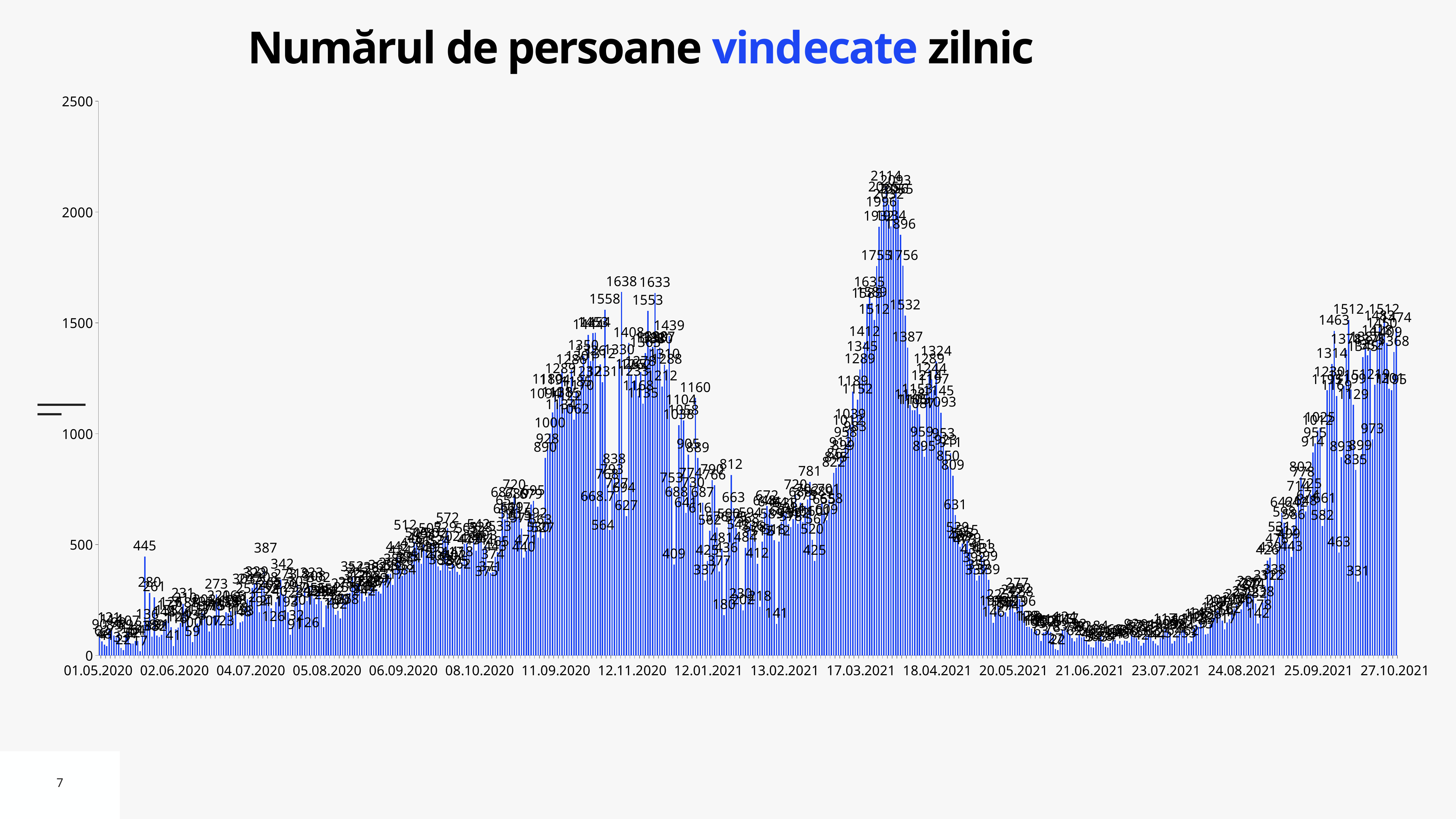
Do the values rise or fall between 20.05.2021 and 21.06.2021? fall Is the highest bar near 17.03.2021 greater or less than 2000? greater Do the values rise or fall between 24.08.2021 and 27.10.2021? rise What is the highest daily value labelled on the chart? 2114 What kind of chart is shown on the slide? bar chart What is the difference between the overall peak value (2114) and the November 2020 peak value (1638)? 476 What is the highest value labelled in the peak around 12.11.2020? 1638 What is the title of the chart? Numărul de persoane vindecate zilnic Are the values around 21.06.2021 greater or less than 500? less How many date labels are shown on the horizontal axis? 18 What is the maximum value shown on the vertical axis? 2500 Which peak is higher: the one around 17.03.2021 or the one around 12.11.2020? the one around 17.03.2021